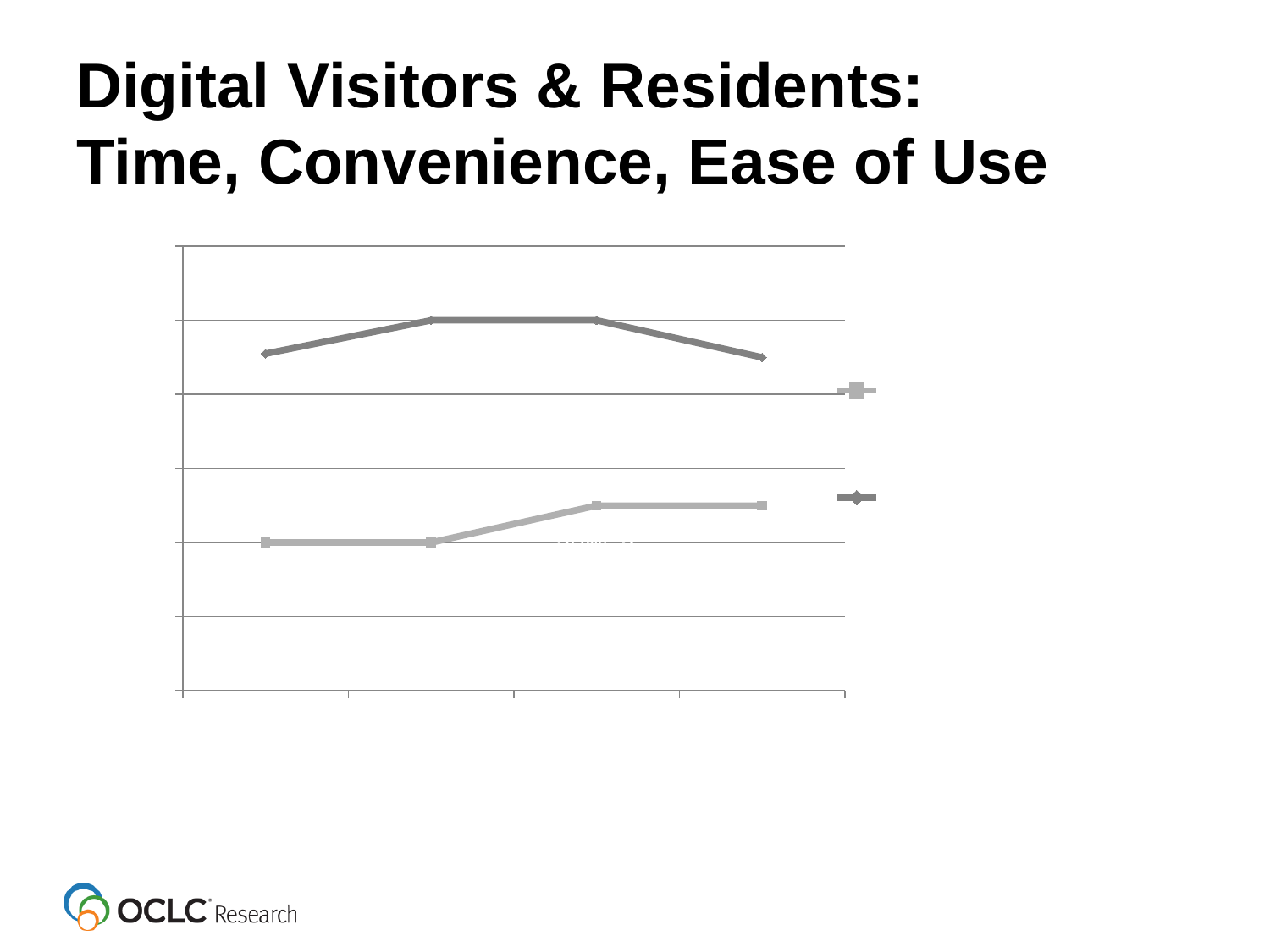
How many series does the legend list? 2 Does the lighter line rise, fall or stay flat between its first and second points? stay flat Does the darker line rise or fall between its third and fourth points? fall Which marker shape is used for the darker line, diamonds or squares? diamonds Does the lighter line rise or fall between its second and third points? rise Which line is plotted higher on the chart, the darker line or the lighter line? the darker line What is the title of the slide containing the chart? Digital Visitors & Residents: Time, Convenience, Ease of Use What kind of chart is shown on the slide? line chart How many data points does each line have? 4